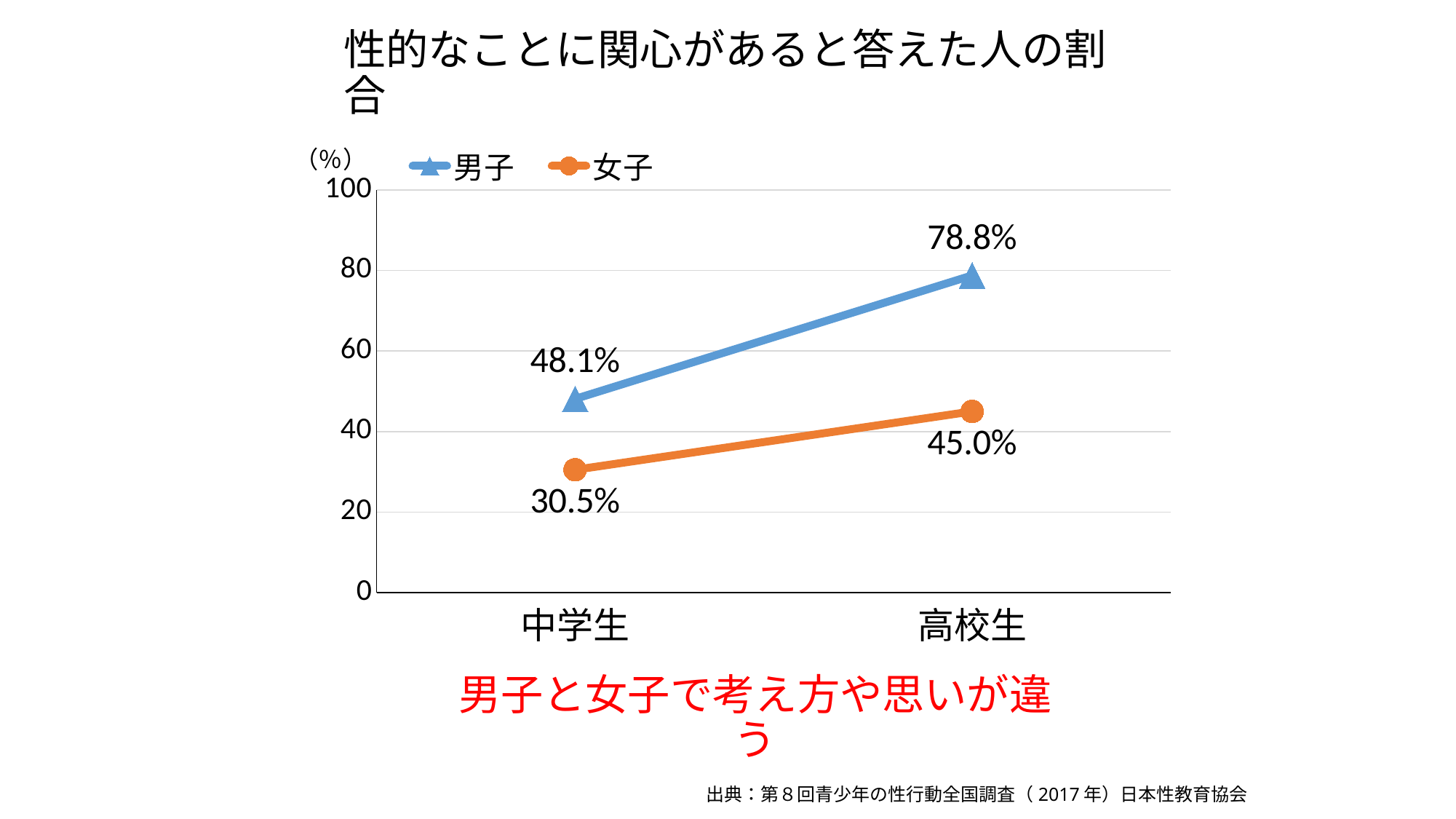
What is the title of the chart? 性的なことに関心があると答えた人の割合 What is the value for 女子 at 中学生? 30.5% What is the value for 男子 at 中学生? 48.1% How many categories are shown on the x axis? 2 Which series has the higher value at 高校生, 男子 or 女子? 男子 Does the 女子 series rise or fall from 中学生 to 高校生? rise What is the value for 女子 at 高校生? 45.0% How many series does the legend list? 2 What is the difference between the 男子 values at 高校生 and 中学生? 30.7% What is the difference between the 男子 and 女子 values at 中学生? 17.6% What is the value for 男子 at 高校生? 78.8% What kind of chart is shown on the slide? line chart